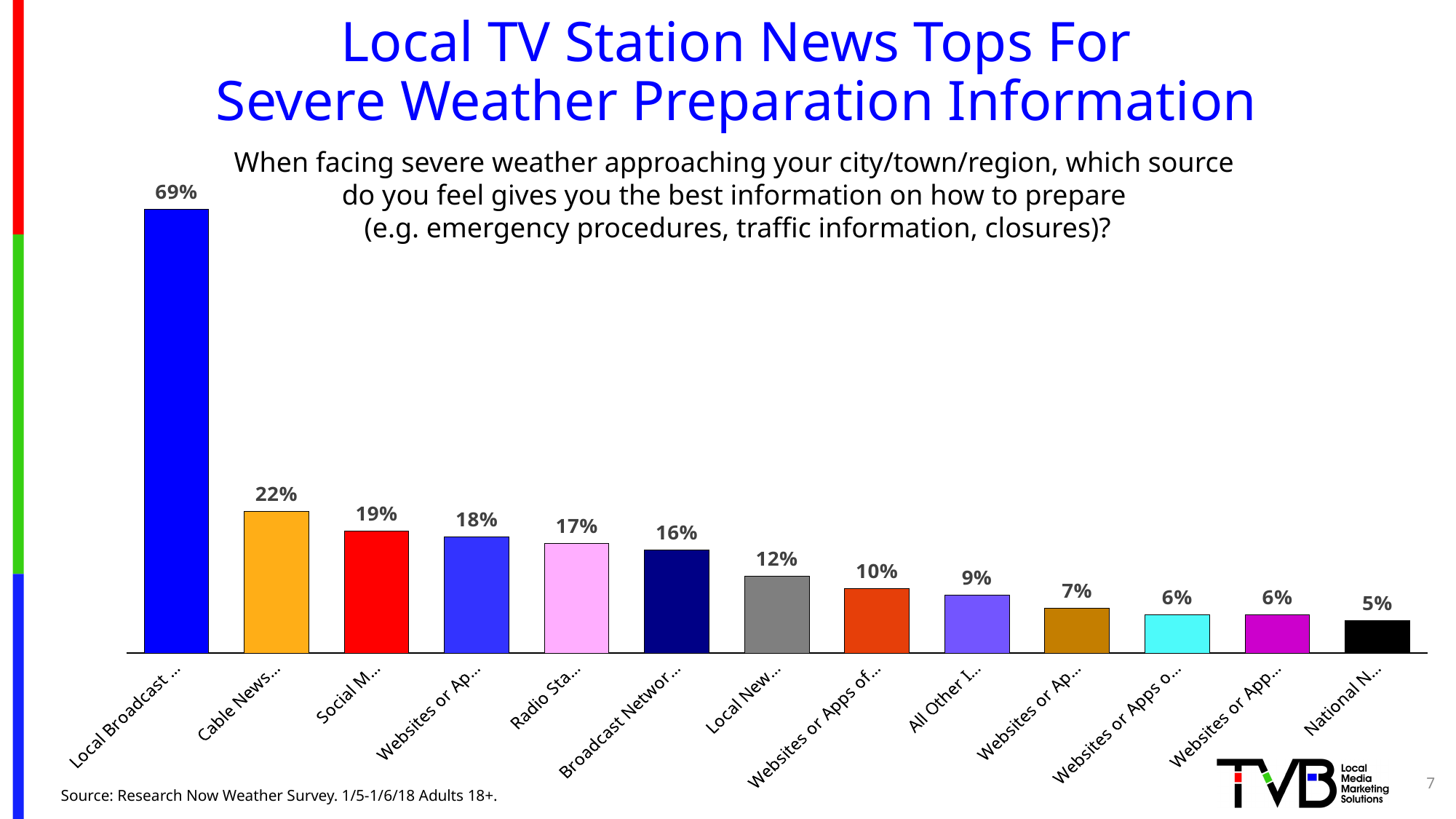
How many bars (categories) are plotted in the chart? 13 What is the value for the first bar, labelled "Local Broadcast ..."? 69% Which is larger, the value for "Social M..." or the value for "Broadcast Networ..."? Social M... What kind of chart is shown on the slide? bar chart What is the value for the bar labelled "All Other I..."? 9% What is the difference between the values for "Local Broadcast ..." and "Cable News..."? 47% Do the values rise or fall moving from left to right along the x axis? fall Which category has the lowest value in the chart? National N... What is the value for the bar labelled "National N..."? 5% What is the value for the bar labelled "Radio Sta..."? 17% What is the value for the bar labelled "Cable News..."? 22% Which category has the highest value in the chart? Local Broadcast ...